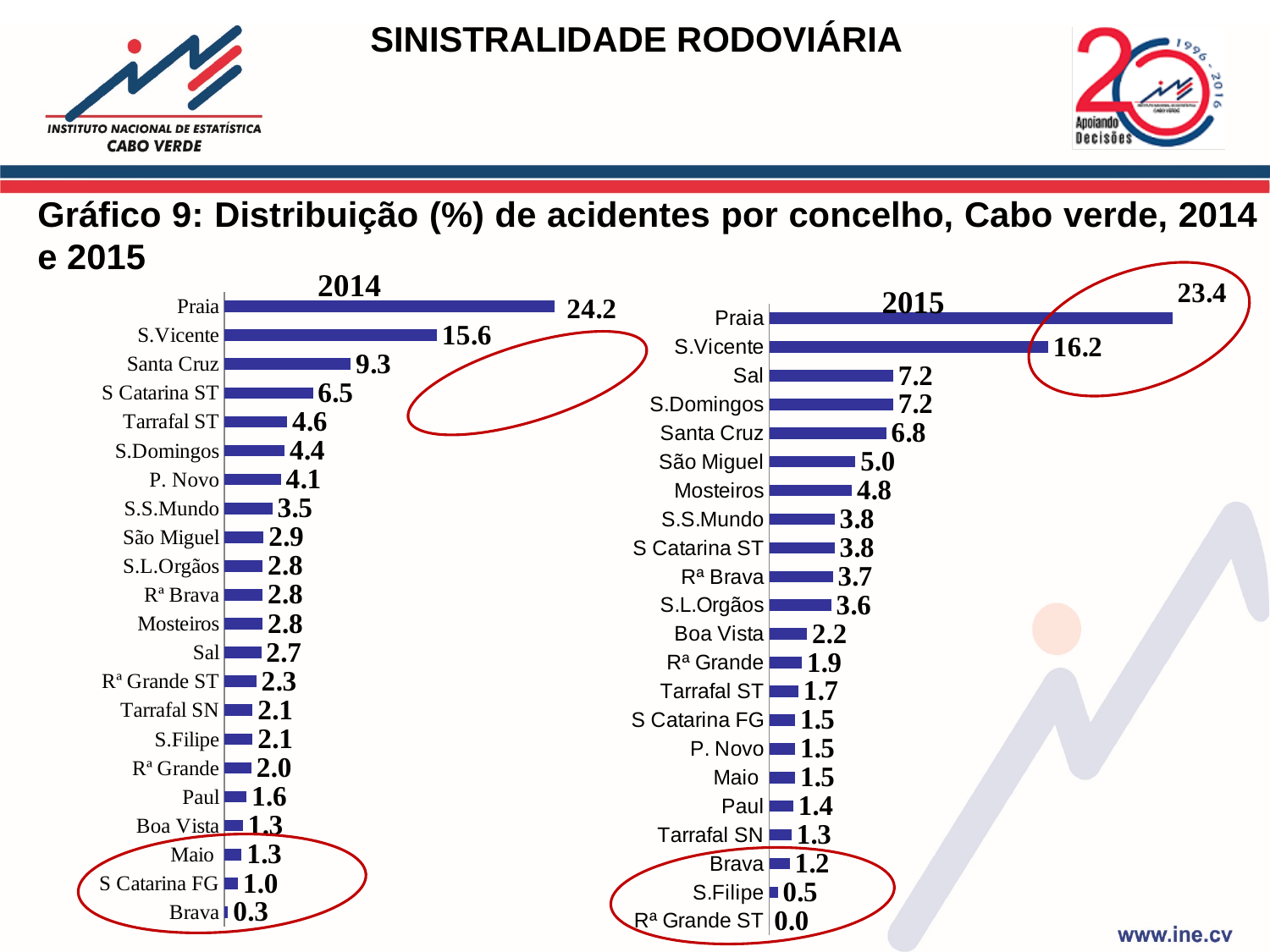
In the 2015 chart, which concelho has the lowest value? Rª Grande ST In the 2014 chart, which is larger, the value for Tarrafal ST or the value for S.Domingos? Tarrafal ST How many concelhos are shown in the 2015 chart? 22 In the 2014 chart, which concelho has the lowest value? Brava In the 2015 chart, which concelho has the highest value? Praia What kind of chart is the 2014 chart? Bar chart In the 2014 chart, what is the difference between the values for Praia and S.Vicente? 8.6 In the 2014 chart, what is the value for Praia? 24.2 In the 2014 chart, what is the value for Santa Cruz? 9.3 What is the title of the chart on the right? 2015 In the 2015 chart, what is the value for Sal? 7.2 In the 2015 chart, what is the difference between the values for S.Vicente and Santa Cruz? 9.4